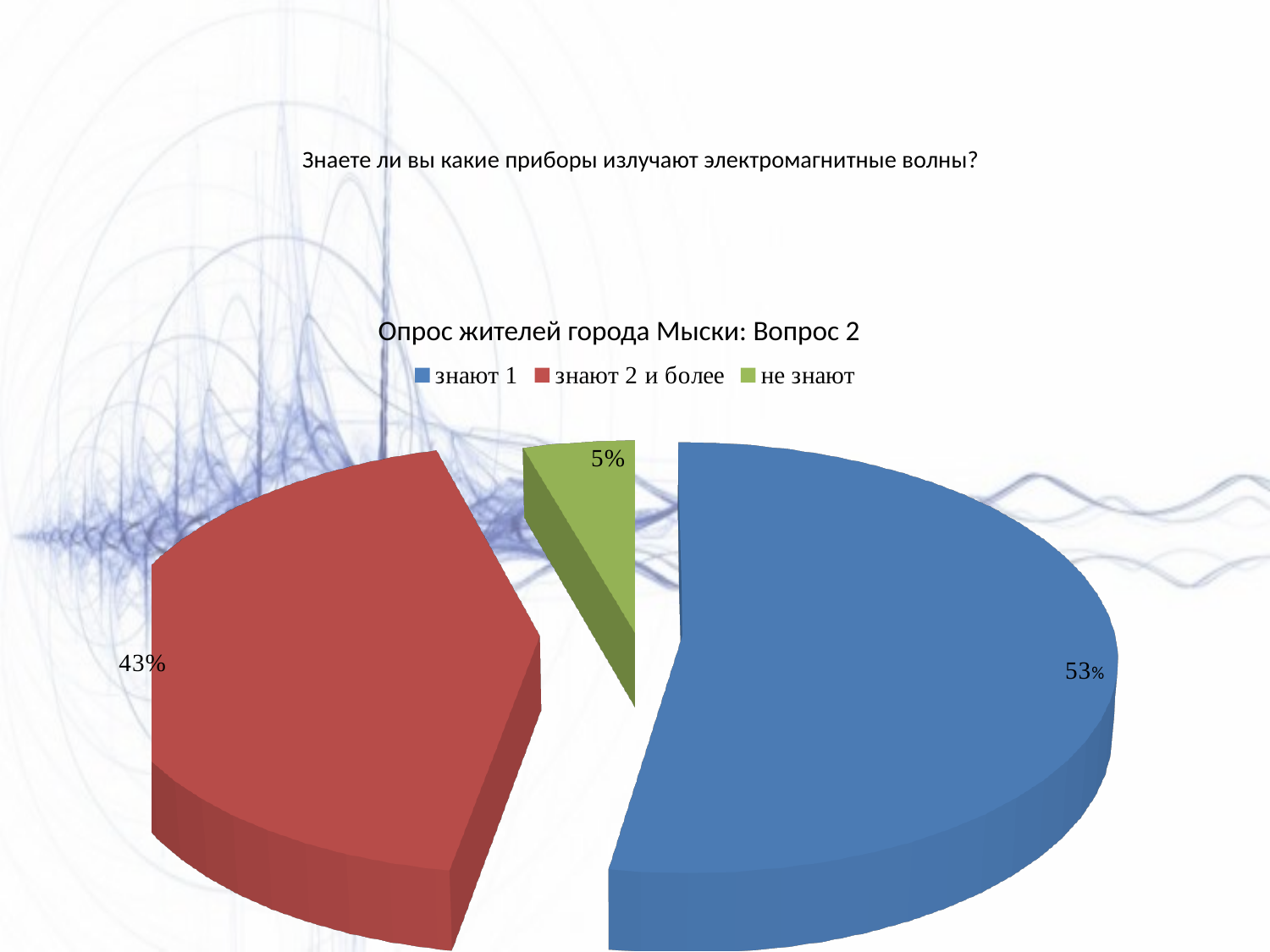
What colour is the slice for 'не знают'? Green What share of the pie is labelled for 'знают 1'? 53% What is the title of the chart? Опрос жителей города Мыски: Вопрос 2 What is the difference in percentage points between 'знают 1' and 'знают 2 и более'? 10 How many categories does the legend list? 3 What type of chart is shown on the slide? Pie chart What share of the pie is labelled for 'знают 2 и более'? 43% What share of the pie is labelled for 'не знают'? 5% How many slices does the pie chart have? 3 Which category has the smallest slice? не знают Which category has the largest slice? знают 1 Which is larger, the slice for 'знают 2 и более' or the slice for 'не знают'? знают 2 и более